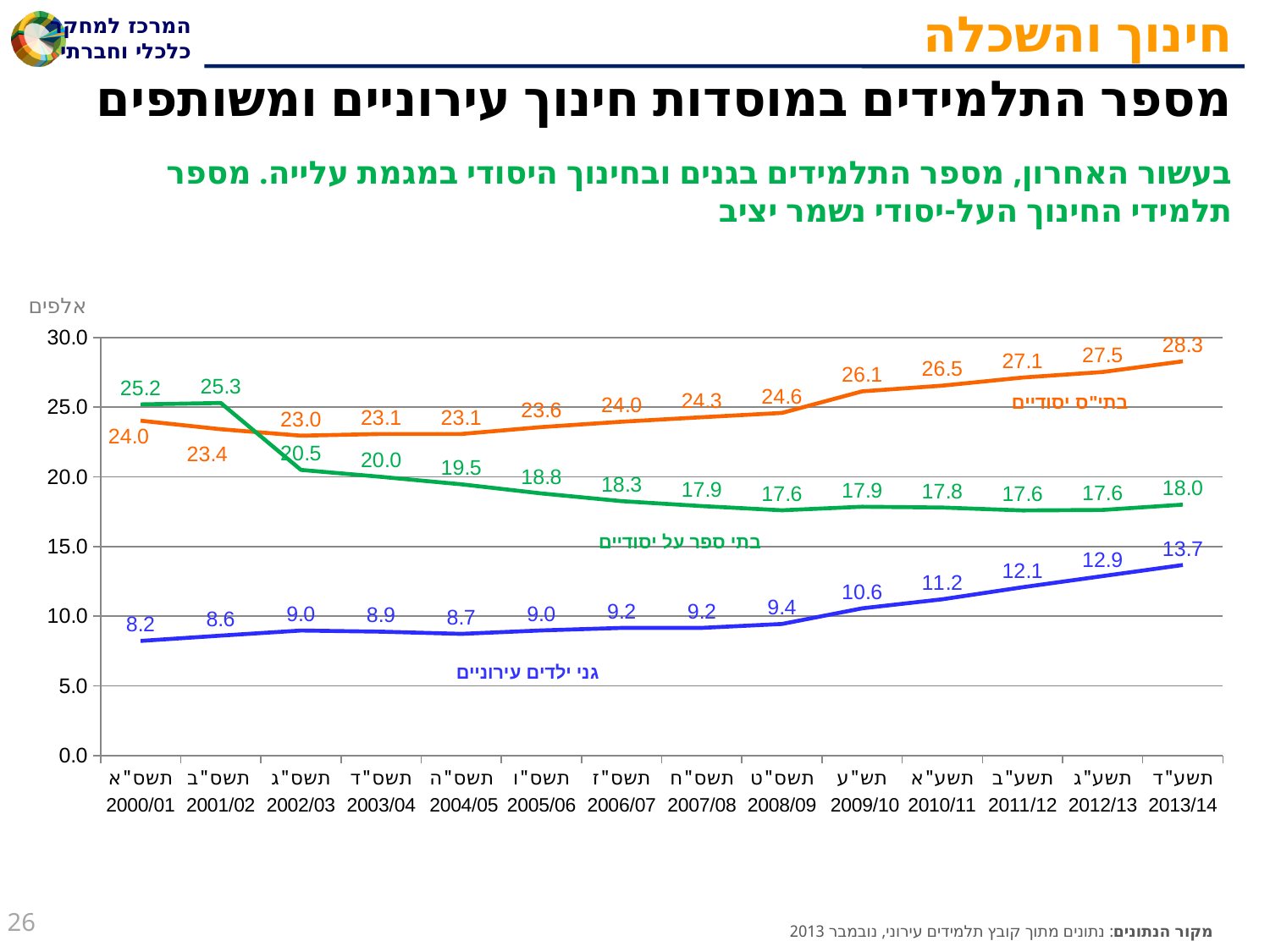
What is the difference between the בתי"ס יסודיים value in 2013/14 and in 2000/01? 4.3 Does the גני ילדים עירוניים (municipal kindergartens) line generally rise or fall from 2008/09 to 2013/14? rise In which school year does the גני ילדים עירוניים (municipal kindergartens) line have its lowest value? 2000/01 What is the value for בתי"ס יסודיים (elementary schools) in 2013/14? 28.3 How many series (lines) are plotted on the chart? 3 How many school years (data points) are shown on the x axis? 14 What is the value for בתי ספר על יסודיים (secondary schools) in 2008/09? 17.6 What unit label is shown above the y axis? אלפים Which series has the higher value in 2000/01: בתי"ס יסודיים or בתי ספר על יסודיים? בתי ספר על יסודיים What is the value for גני ילדים עירוניים (municipal kindergartens) in 2000/01? 8.2 What type of chart is shown on the slide? line chart In which school year does the בתי"ס יסודיים (elementary schools) line reach its highest value? 2013/14